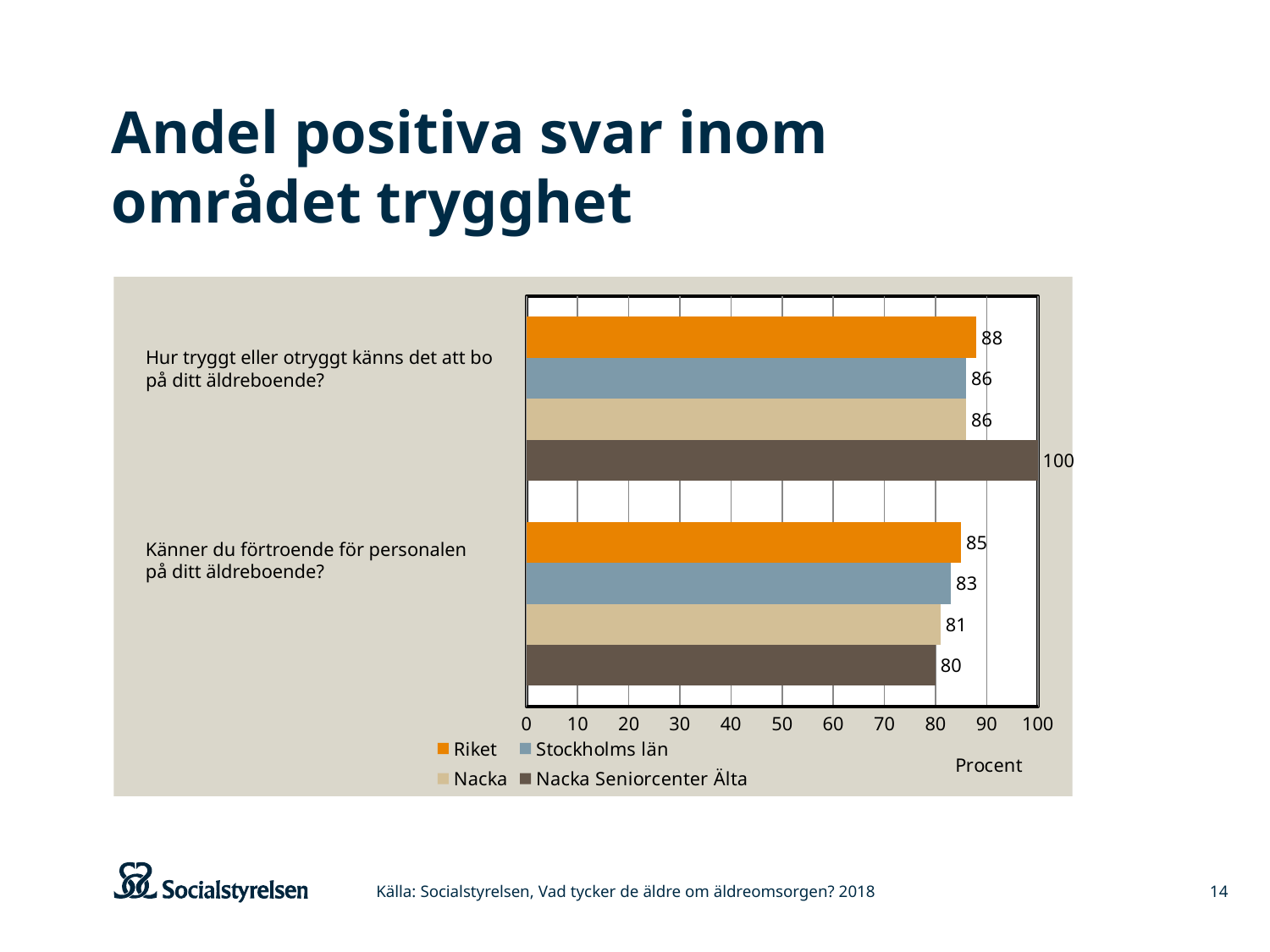
What kind of chart is shown on the slide? Bar chart What is the value for Nacka on the question "Känner du förtroende för personalen på ditt äldreboende?"? 81 What unit is shown on the horizontal axis of the chart? Procent What is the value for Riket on the question "Känner du förtroende för personalen på ditt äldreboende?"? 85 Which series has the lowest value on the question "Känner du förtroende för personalen på ditt äldreboende?"? Nacka Seniorcenter Älta What is the value for Stockholms län on the question "Hur tryggt eller otryggt känns det att bo på ditt äldreboende?"? 86 Which series is shown in orange in the legend? Riket Which series has the highest value on the question "Hur tryggt eller otryggt känns det att bo på ditt äldreboende?"? Nacka Seniorcenter Älta Which is larger on the question "Hur tryggt eller otryggt känns det att bo på ditt äldreboende?": the value for Riket or the value for Nacka? Riket What is the difference between the Riket value and the Nacka Seniorcenter Älta value on the question "Känner du förtroende för personalen på ditt äldreboende?"? 5 What is the value for Nacka Seniorcenter Älta on the question "Hur tryggt eller otryggt känns det att bo på ditt äldreboende?"? 100 How many series does the legend list? 4